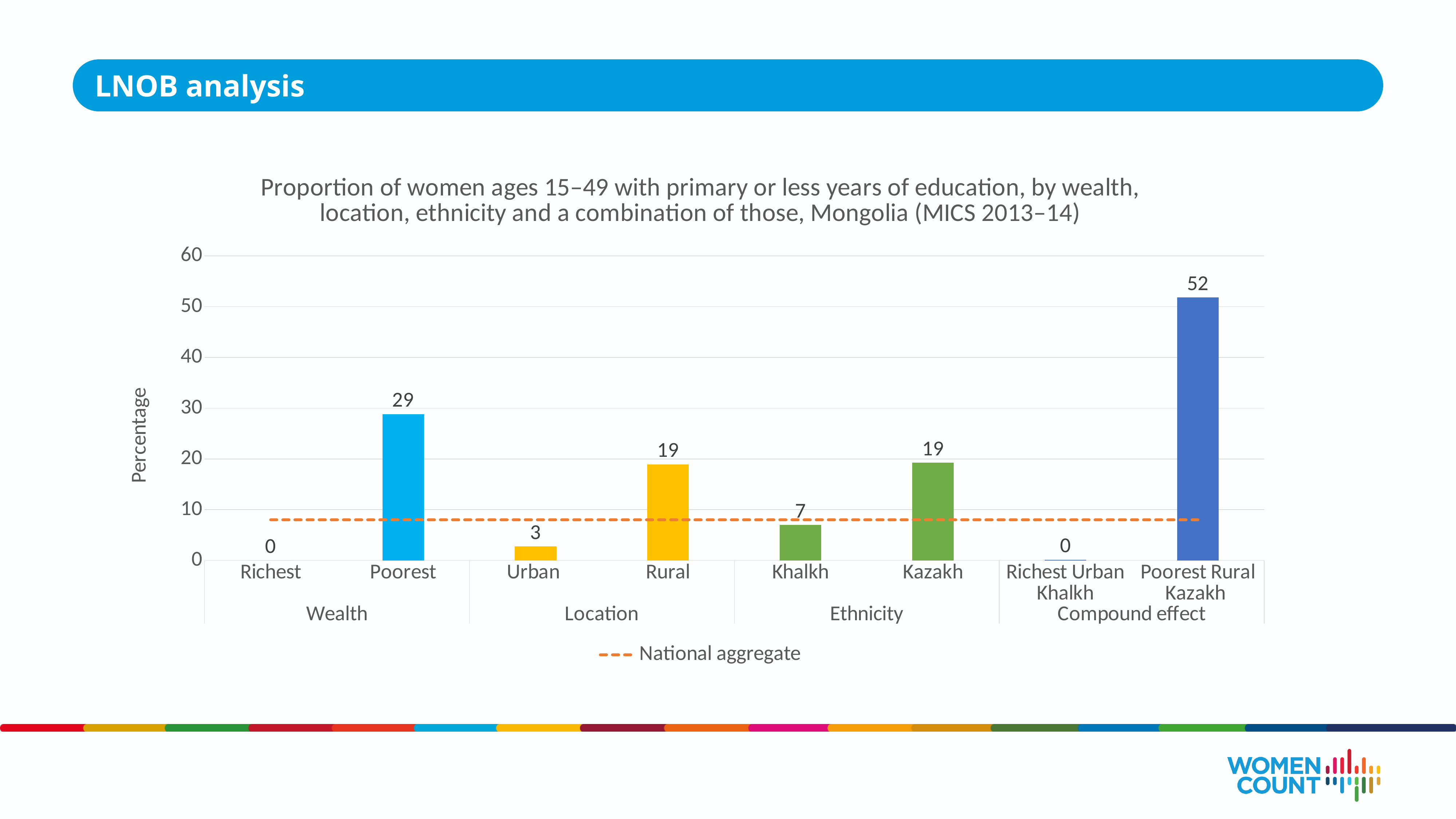
What does the dashed orange line represent according to the legend? National aggregate Which is larger, the value for Kazakh or the value for Khalkh? Kazakh What is the difference between the values for Rural and Urban? 16 What is the difference between the values for Poorest Rural Kazakh and Poorest? 23 What is the value for Khalkh? 7 Is the National aggregate line greater or less than 10? less What is the value for Urban? 3 What is the value for Poorest Rural Kazakh? 52 How many categories are shown on the x axis? 8 What kind of chart is this? bar chart Which category has the highest value? Poorest Rural Kazakh What is the value for Poorest in the Wealth group? 29